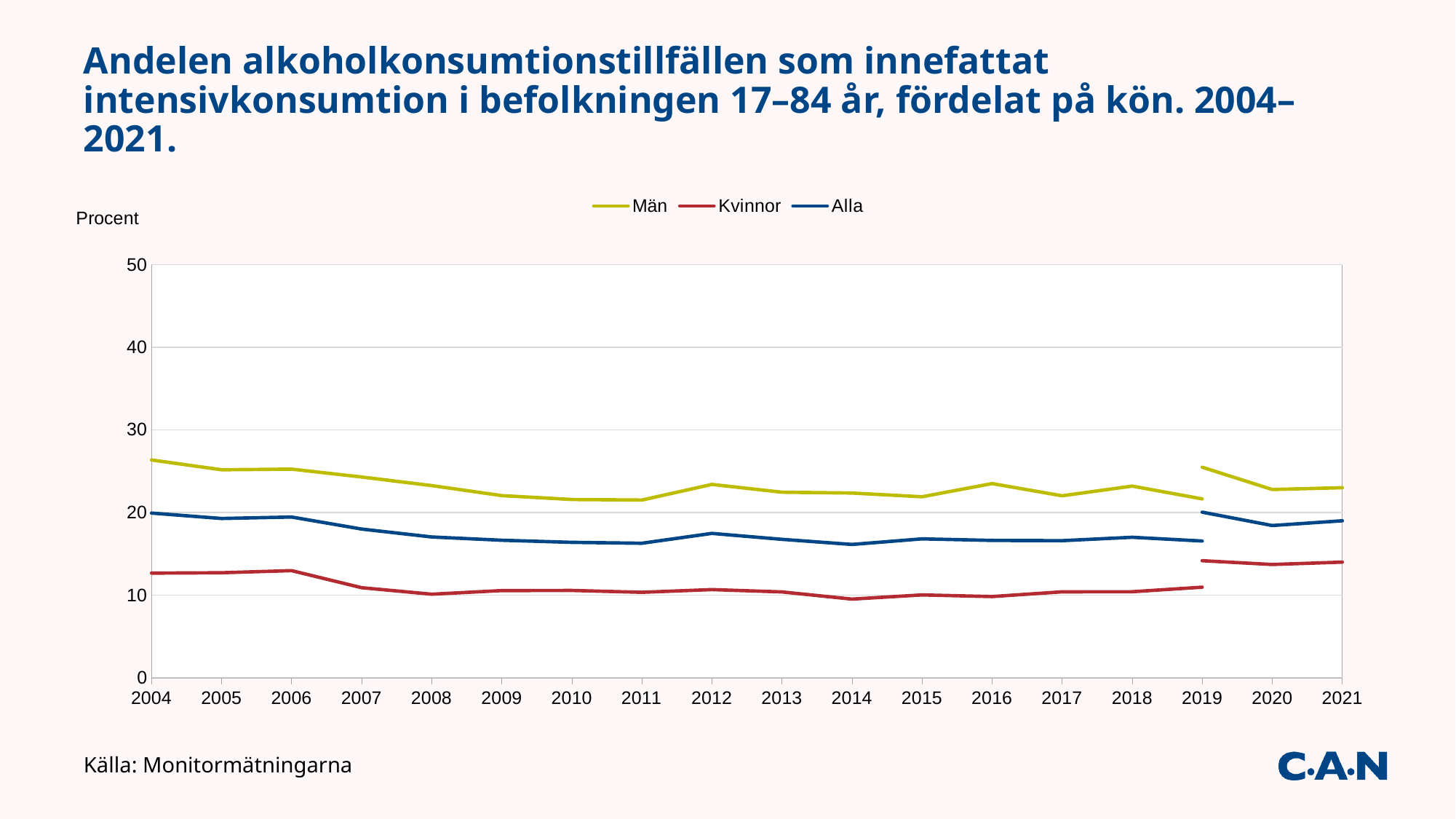
Is the value for Alla in 2012 greater or less than 20? less Do the values for Män rise or fall from 2004 to 2011? fall Is the value for Män in 2004 greater or less than 30? less How many series does the legend list? 3 What is the label on the y axis? Procent Which series has the lowest values across the whole period? Kvinnor Which series has the highest values across the whole period? Män Which is larger in 2010, the value for Män or the value for Kvinnor? Män Is the value for Män in 2004 greater or less than 20? greater What kind of chart is shown on the slide? line chart How many years are labelled on the x axis? 18